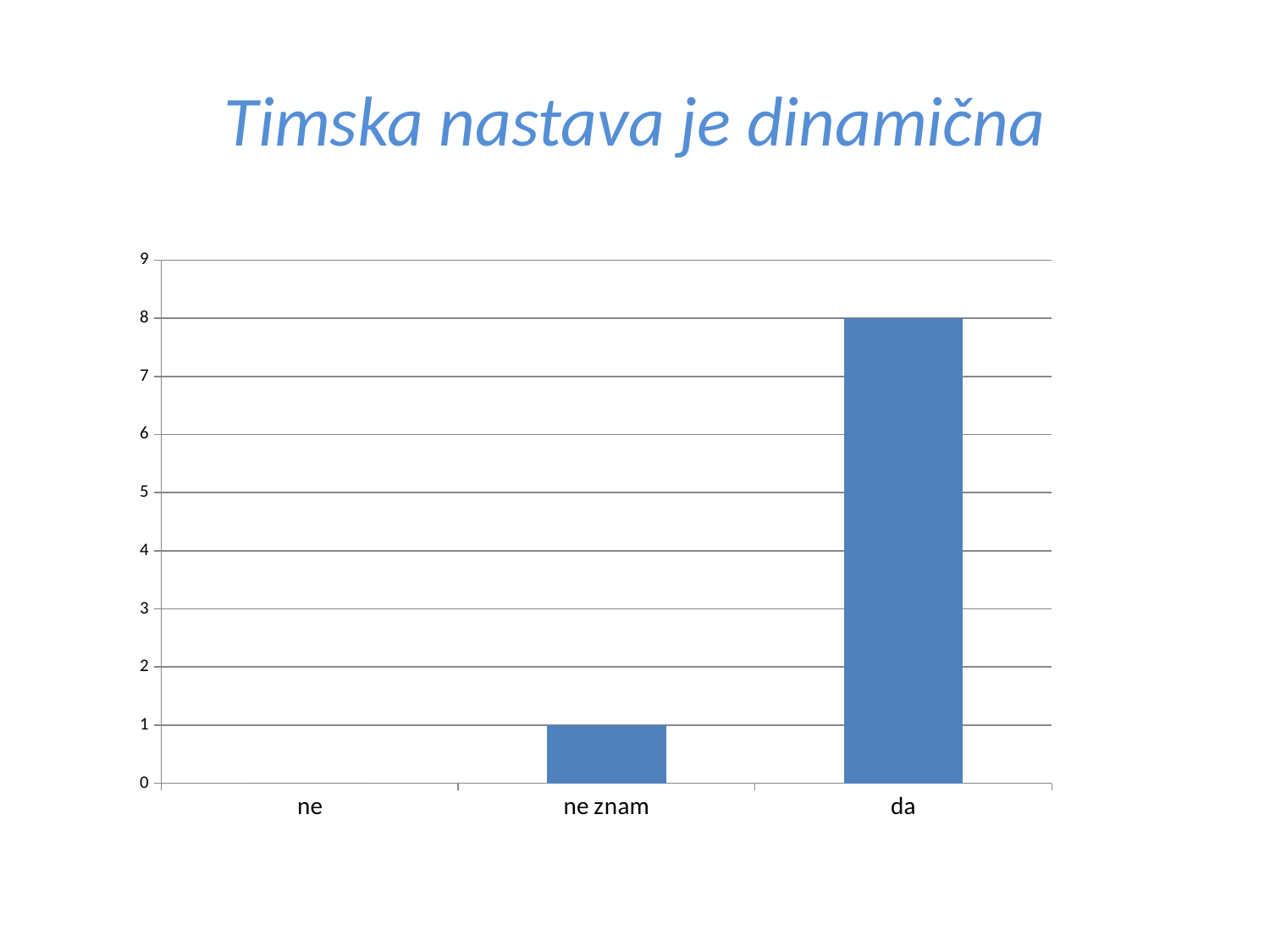
Which is larger, the value for "da" or the value for "ne znam"? da What is the value for "ne"? 0 What is the value for "ne znam"? 1 What is the difference between the values for "da" and "ne znam"? 7 Is the value for "da" greater or less than 5? greater What kind of chart is shown on the slide? bar chart Which category has the highest value? da Do the values rise or fall from left to right along the x axis? rise Which category has the lowest value? ne What is the value for "da"? 8 How many categories are shown on the x axis? 3 What is the title of the slide? Timska nastava je dinamična